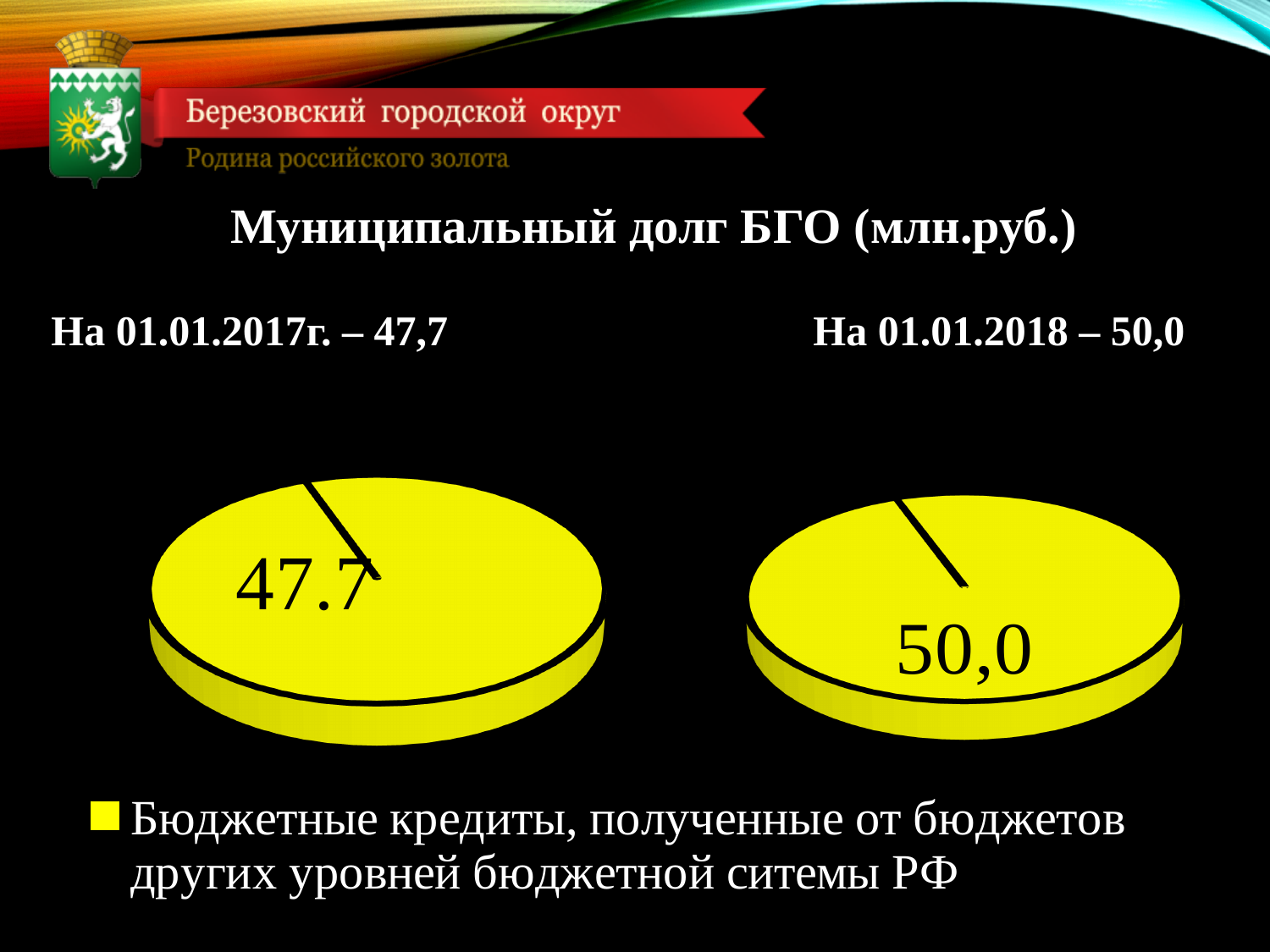
What colour are the slices in both pie charts? yellow What type of chart is shown on the left side of the slide? pie chart How many slices does the right pie chart (На 01.01.2018) have? 1 Which is larger: the value in the left pie chart (01.01.2017) or the value in the right pie chart (01.01.2018)? the right pie chart (01.01.2018) What share of the left pie chart (На 01.01.2017г.) does the single slice occupy? 100% How many entries does the legend at the bottom of the slide list? 1 In the left pie chart (На 01.01.2017г.), what value is printed on the slice? 47.7 What type of chart is shown on the right side of the slide? pie chart How many slices does the left pie chart (На 01.01.2017г.) have? 1 What is the difference between the value in the right pie chart (50,0) and the value in the left pie chart (47,7)? 2,3 What is the title above the two pie charts? Муниципальный долг БГО (млн.руб.) In the right pie chart (На 01.01.2018), what value is printed on the slice? 50,0